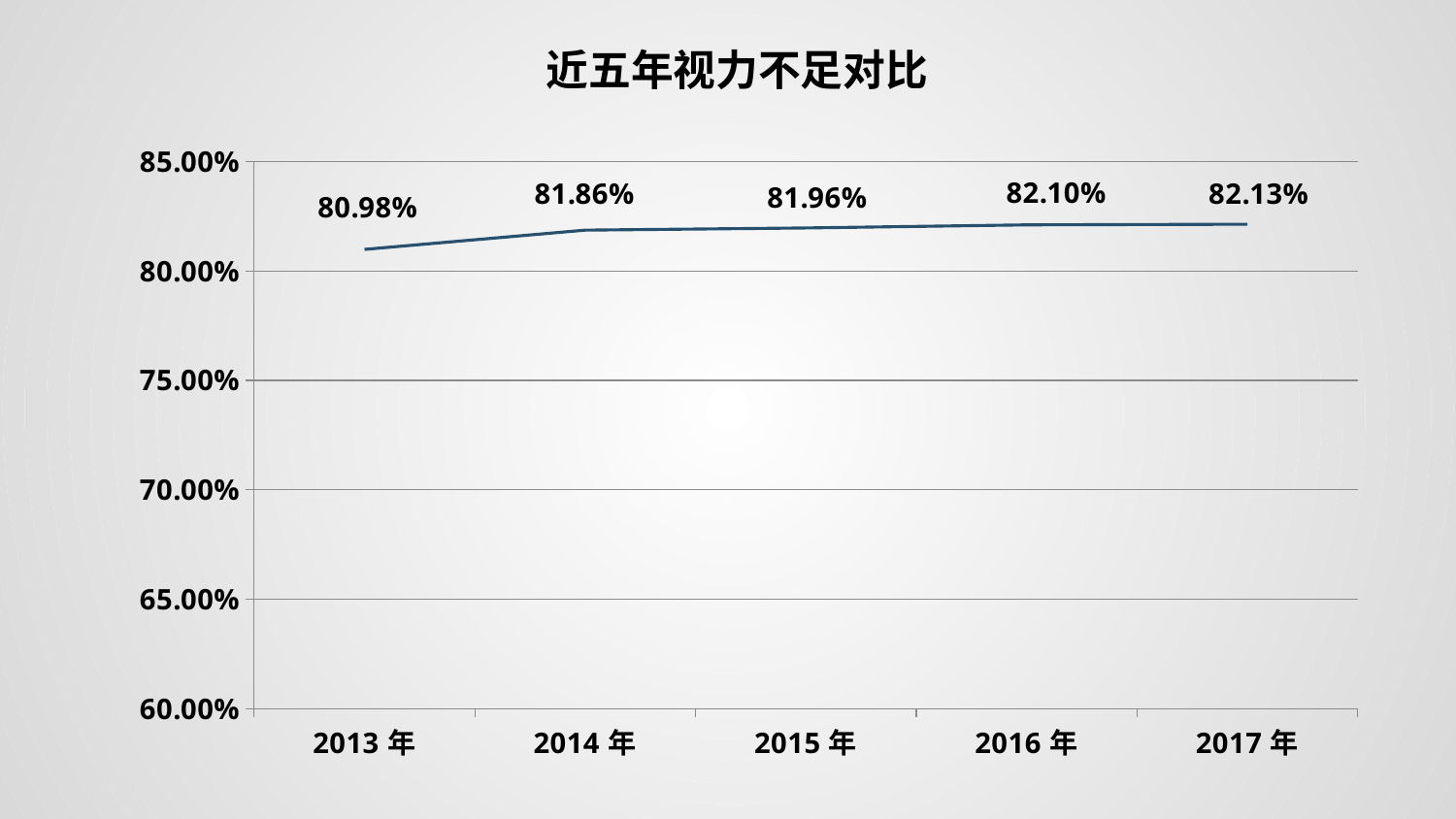
What is the difference between the values for 2017 年 and 2013 年? 1.15% Which year has the highest value? 2017 年 What is the value for 2013 年? 80.98% What is the difference between the values for 2014 年 and 2013 年? 0.88% Do the values rise or fall from 2013 年 to 2017 年? rise Which is larger, the value for 2014 年 or the value for 2013 年? 2014 年 What is the value for 2017 年? 82.13% Which year has the lowest value? 2013 年 What kind of chart is shown on the slide? line chart What is the value for 2015 年? 81.96% How many years are plotted on the chart? 5 Is the value for 2016 年 greater or less than 80.00%? greater